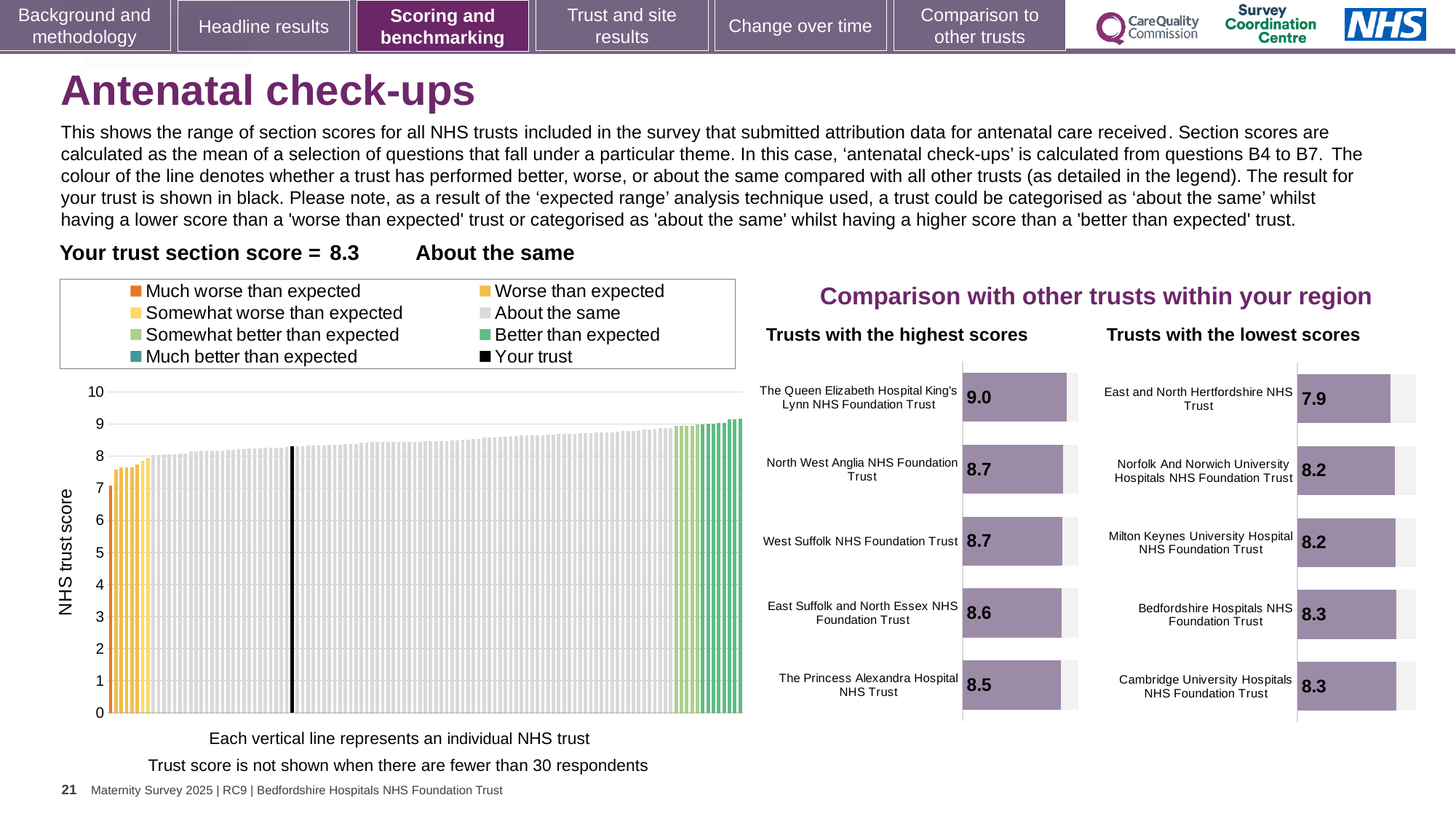
How many entries does the legend of the NHS trust score chart list? 8 In the 'Trusts with the highest scores' chart, what is the score for West Suffolk NHS Foundation Trust? 8.7 In the 'Trusts with the lowest scores' chart, which has the higher score: Bedfordshire Hospitals NHS Foundation Trust or East and North Hertfordshire NHS Trust? Bedfordshire Hospitals NHS Foundation Trust How many trusts are listed in the 'Trusts with the highest scores' chart? 5 In the 'Trusts with the highest scores' chart, which trust has the highest score? The Queen Elizabeth Hospital King's Lynn NHS Foundation Trust In the 'Trusts with the lowest scores' chart, which trust has the lowest score? East and North Hertfordshire NHS Trust In the 'Trusts with the highest scores' chart, what is the difference between the scores of The Queen Elizabeth Hospital King's Lynn NHS Foundation Trust and The Princess Alexandra Hospital NHS Trust? 0.5 In the 'Trusts with the lowest scores' chart, what is the score for East and North Hertfordshire NHS Trust? 7.9 In the NHS trust score chart on the left, do the values rise or fall from left to right? rise What kind of chart is the NHS trust score chart on the left of the slide? bar chart In the 'Trusts with the highest scores' chart, what is the score for The Queen Elizabeth Hospital King's Lynn NHS Foundation Trust? 9.0 What is the title of the section containing the two small bar charts on the right of the slide? Comparison with other trusts within your region